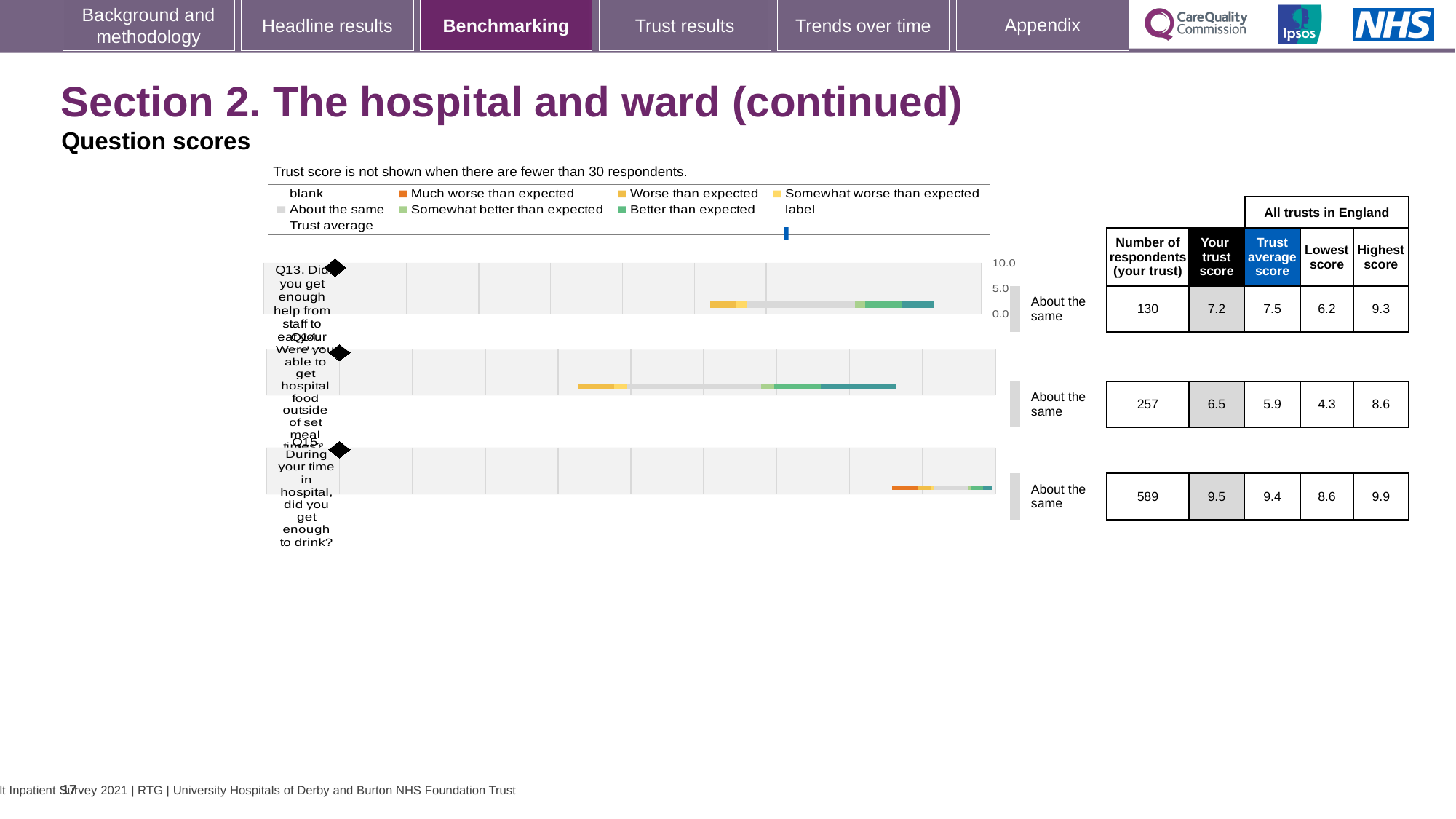
Which question has the highest 'Your trust score'? Q15 How many questions are charted on this slide? 3 How many respondents from your trust answered Q13 (Did you get enough help from staff to eat your meals)? 130 What is the highest score across all trusts in England for Q14? 8.6 For Q13, which is larger: your trust score or the trust average score? Trust average score What is your trust score for Q14 (Were you able to get hospital food outside of set meal times)? 6.5 What is the trust average score for Q15 (During your time in hospital, did you get enough to drink)? 9.4 Is the trust average score for Q15 greater or less than 5.0? greater Which question has the lowest number of respondents from your trust? Q13 What is the lowest score across all trusts in England for Q13? 6.2 What benchmark category is shown next to the chart for Q15? About the same For Q14, what is the difference between your trust score and the trust average score? 0.6